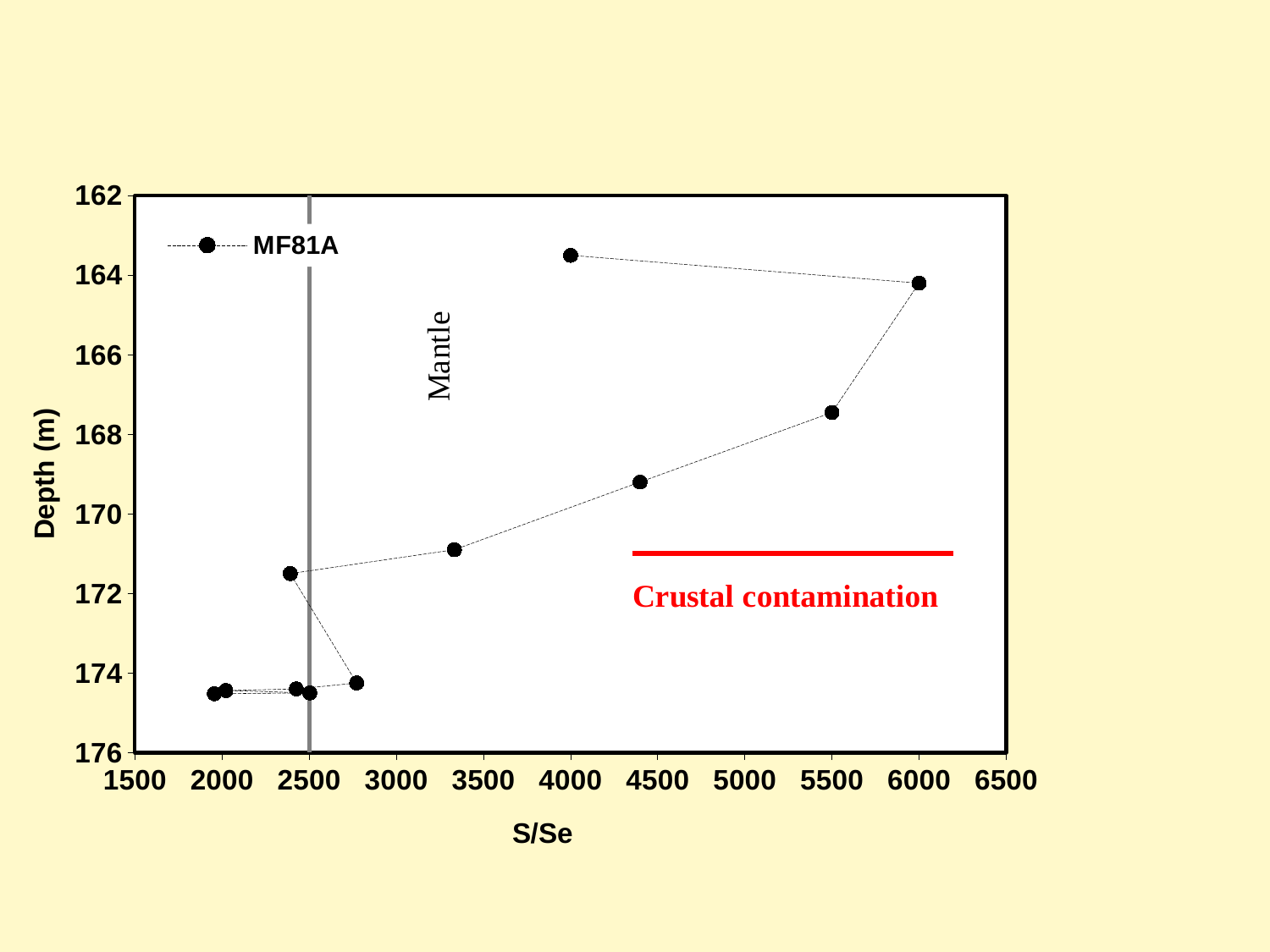
Which has the larger S/Se value: the point near 167.5 m depth or the point near 169 m depth? the point near 167.5 m depth Is the S/Se value of the shallowest point (near 163.5 m depth) greater or less than 4500? less Is the S/Se value of the point near 167.5 m depth greater or less than 5000? greater Is the S/Se value of the point near 171.5 m depth greater or less than 3000? less What kind of chart is shown on the slide? scatter plot with connected points What is the label of the x axis? S/Se What is the name of the series shown in the legend? MF81A How many series does the legend list? 1 Which has the larger S/Se value: the point near 164 m depth or the point near 171.5 m depth? the point near 164 m depth